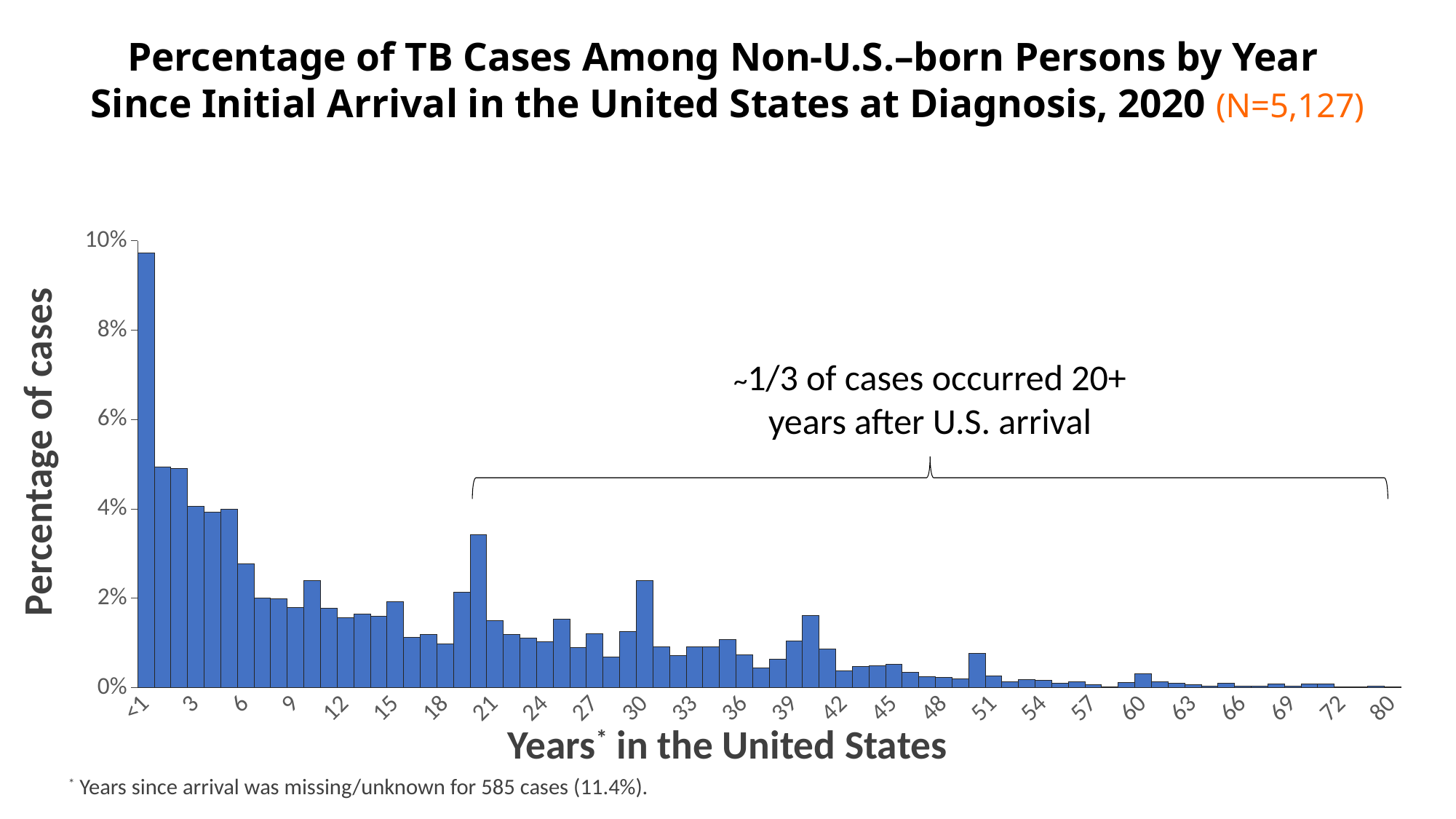
Which category on the x axis has the highest percentage of cases? <1 Is the value for 6 years in the United States greater or less than 6%? less What kind of chart is shown on the slide? bar chart Is the value for <1 years in the United States greater or less than 8%? greater What is the title of the y axis? Percentage of cases Is the value for 21 years in the United States greater or less than 4%? less According to the annotation on the chart, what fraction of cases occurred 20+ years after U.S. arrival? ~1/3 Which is larger, the value for <1 years or the value for 21 years in the United States? <1 years Which is larger, the value for 21 years or the value for 60 years in the United States? 21 years Overall, do the percentages rise or fall as years in the United States increase along the x axis? fall